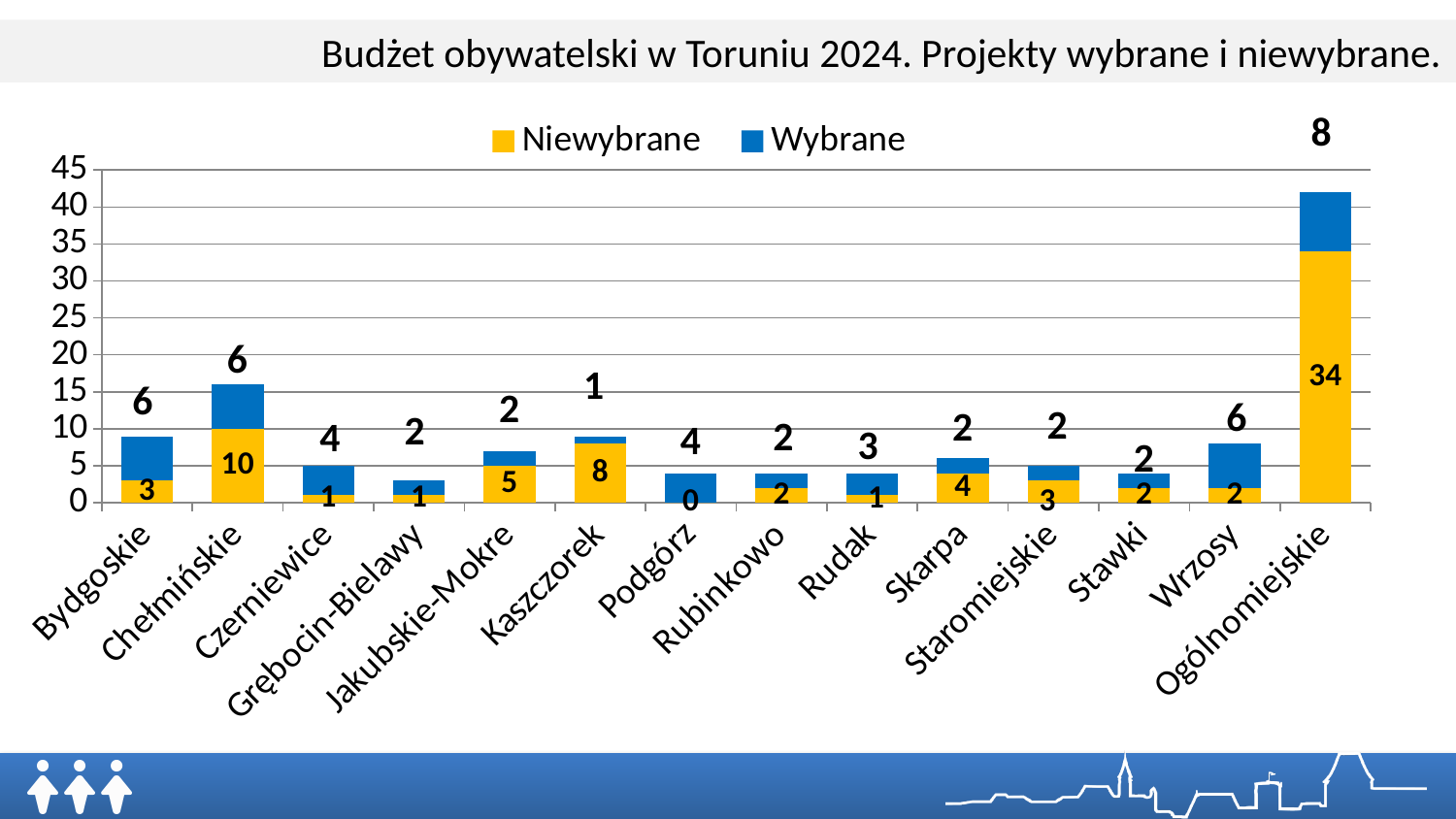
Which category has the lowest Wybrane value? Kaszczorek What is the Niewybrane value for Podgórz? 0 Which is larger, the Wybrane value for Wrzosy or the Wybrane value for Skarpa? Wrzosy What is the total of the stacked bar for Chełmińskie? 16 What is the Wybrane value for Chełmińskie? 6 What kind of chart is shown on the slide? stacked bar chart Is the total stacked value for Ogólnomiejskie greater or less than 40? greater What is the difference between the Niewybrane values for Kaszczorek and Jakubskie-Mokre? 3 What is the Niewybrane value for Ogólnomiejskie? 34 How many series does the legend list? 2 How many categories are shown on the x axis? 14 Which category has the highest Niewybrane value? Ogólnomiejskie